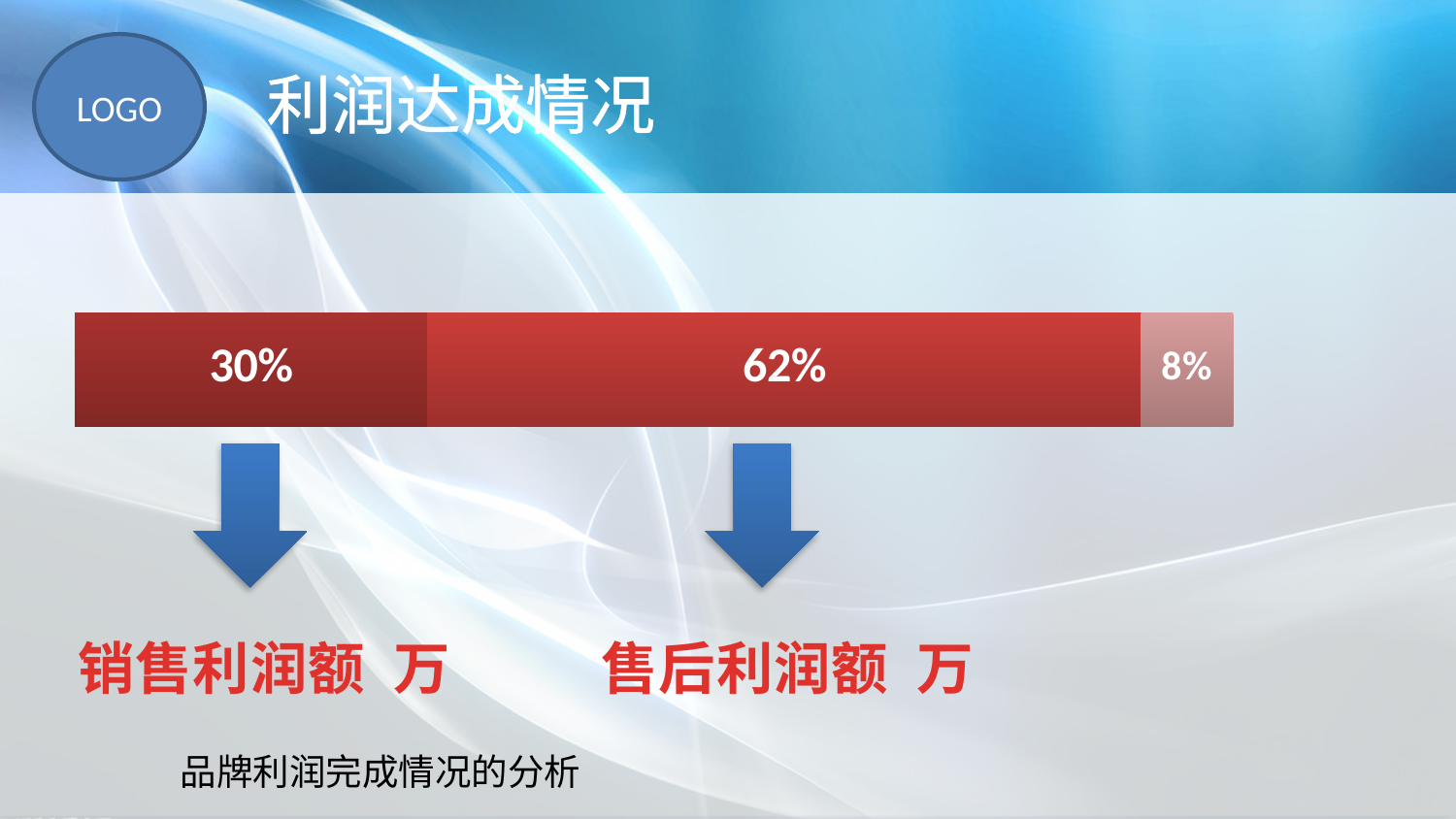
How many segments make up the stacked bar? 3 Which is larger, the share for 销售利润额 or the share for 售后利润额? 售后利润额 What percentage is shown for 售后利润额 in the stacked bar? 62% What kind of chart is shown on the slide? Stacked bar chart What is the total of the three percentages shown in the bar? 100% What colour are the arrows pointing from the bar to the labels below? Blue Which segment of the bar has the smallest percentage? 8% Which segment of the bar has the largest percentage? 62% What percentage is shown for 销售利润额 in the stacked bar? 30% By how many percentage points does 售后利润额 exceed 销售利润额? 32 What percentage is printed on the rightmost (lightest) segment of the bar? 8% What is the title of the slide containing the chart? 利润达成情况